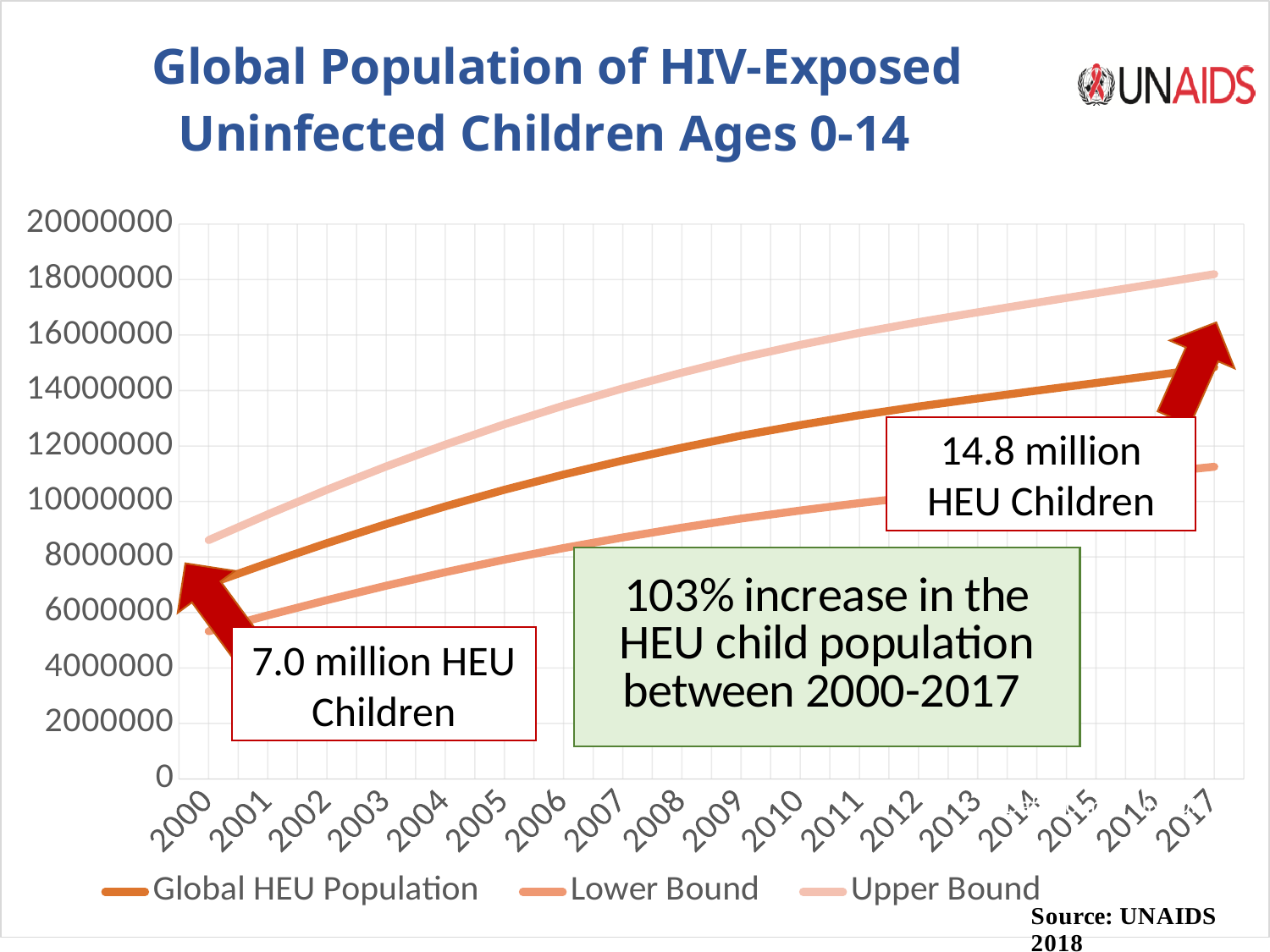
Is the Upper Bound value for 2017 greater or less than 16000000? greater Does the Global HEU Population rise or fall from 2000 to 2017? Rise According to the annotation, what was the Global HEU Population in 2017? 14.8 million How many series does the legend list? 3 Is the Lower Bound value for 2017 greater or less than 10000000? greater Which series has the highest values across the chart: Global HEU Population, Lower Bound, or Upper Bound? Upper Bound According to the annotation, what was the Global HEU Population in 2000? 7.0 million What kind of chart is shown on the slide? Line chart What percentage increase in the HEU child population between 2000 and 2017 does the slide state? 103% By how much did the Global HEU Population grow between 2000 and 2017, based on the annotated values? 7.8 million Is the Lower Bound value for 2000 greater or less than 6000000? less How many years are shown along the x axis? 18